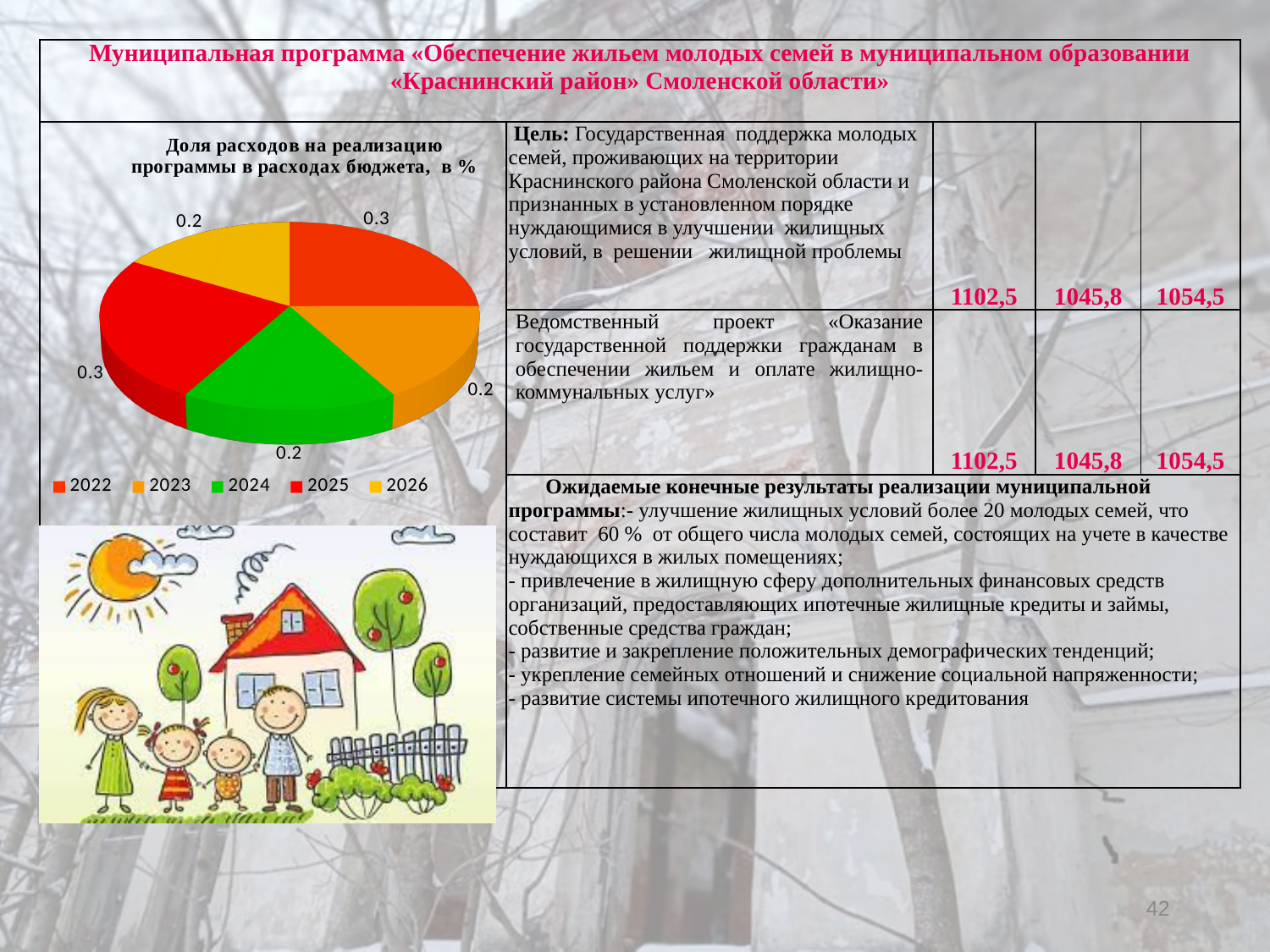
What is the value shown for 2022 in the pie chart? 0.3 Which is larger in the pie chart, the value for 2022 or the value for 2023? 2022 How many categories (years) does the pie chart show? 5 What is the value shown for 2026 in the pie chart? 0.2 Which colour represents 2024 in the pie chart legend? green How many entries does the legend of the pie chart list? 5 What is the value shown for 2025 in the pie chart? 0.3 What is the value shown for 2023 in the pie chart? 0.2 What is the difference between the values for 2025 and 2026 in the pie chart? 0.1 What is the value shown for 2024 in the pie chart? 0.2 What is the title of the pie chart? Доля расходов на реализацию программы в расходах бюджета, в % What type of chart is shown on the slide? pie chart